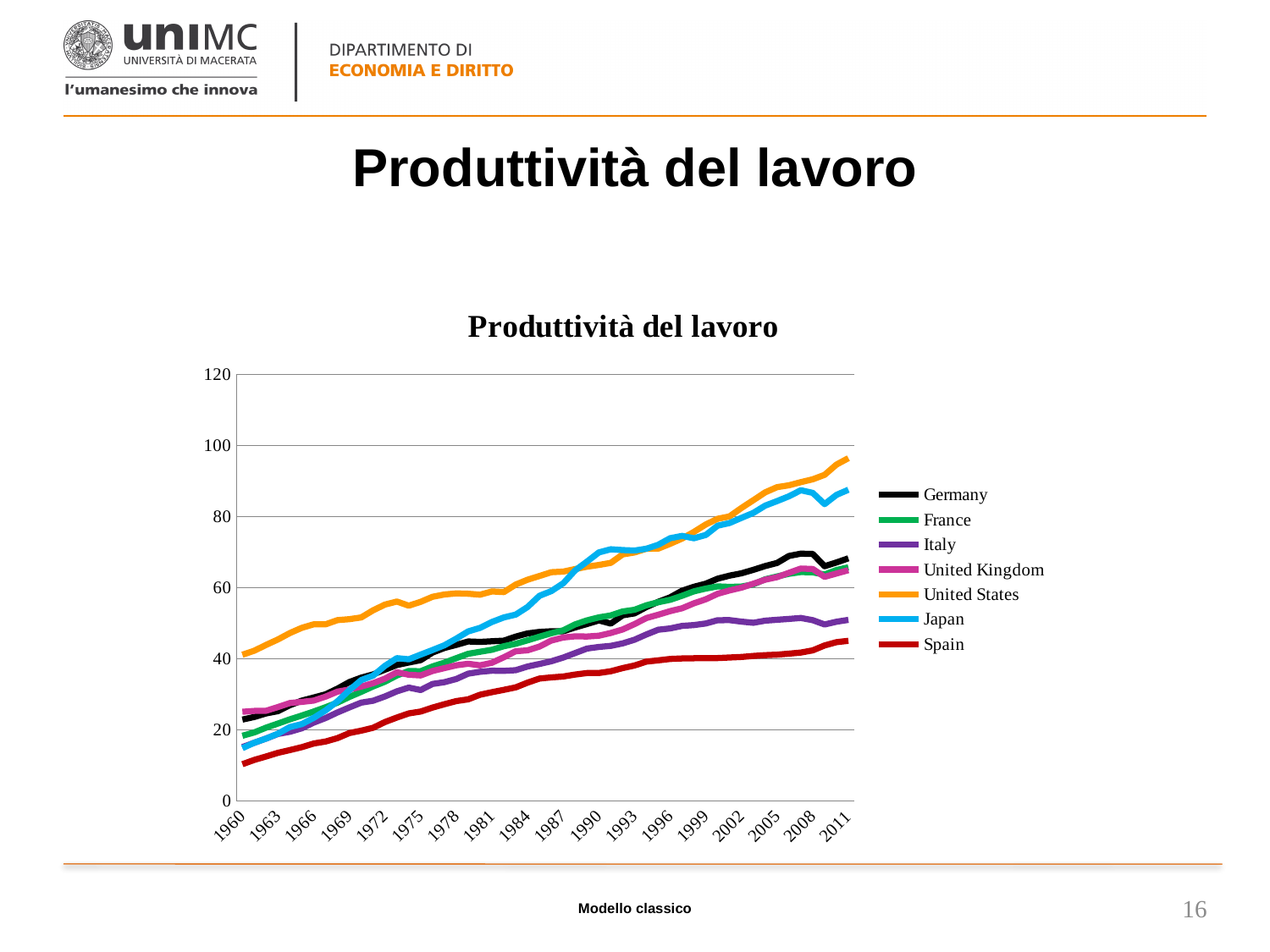
Which country has the lowest value in 1960? Spain What kind of chart is shown on the slide? line chart Does the Spain series rise or fall from 1960 to 2011? rise In 2011, which is higher: Japan or Germany? Japan How many series does the legend list? 7 Which country has the highest labour productivity in 2011? United States Is the value for United States in 2011 greater or less than 80? greater Is the value for Spain in 2011 greater or less than 60? less Is the value for Japan in 1960 greater or less than 20? less Which country has the lowest labour productivity in 2011? Spain What is the title of the chart? Produttività del lavoro What colour is the line for United States in the legend? orange